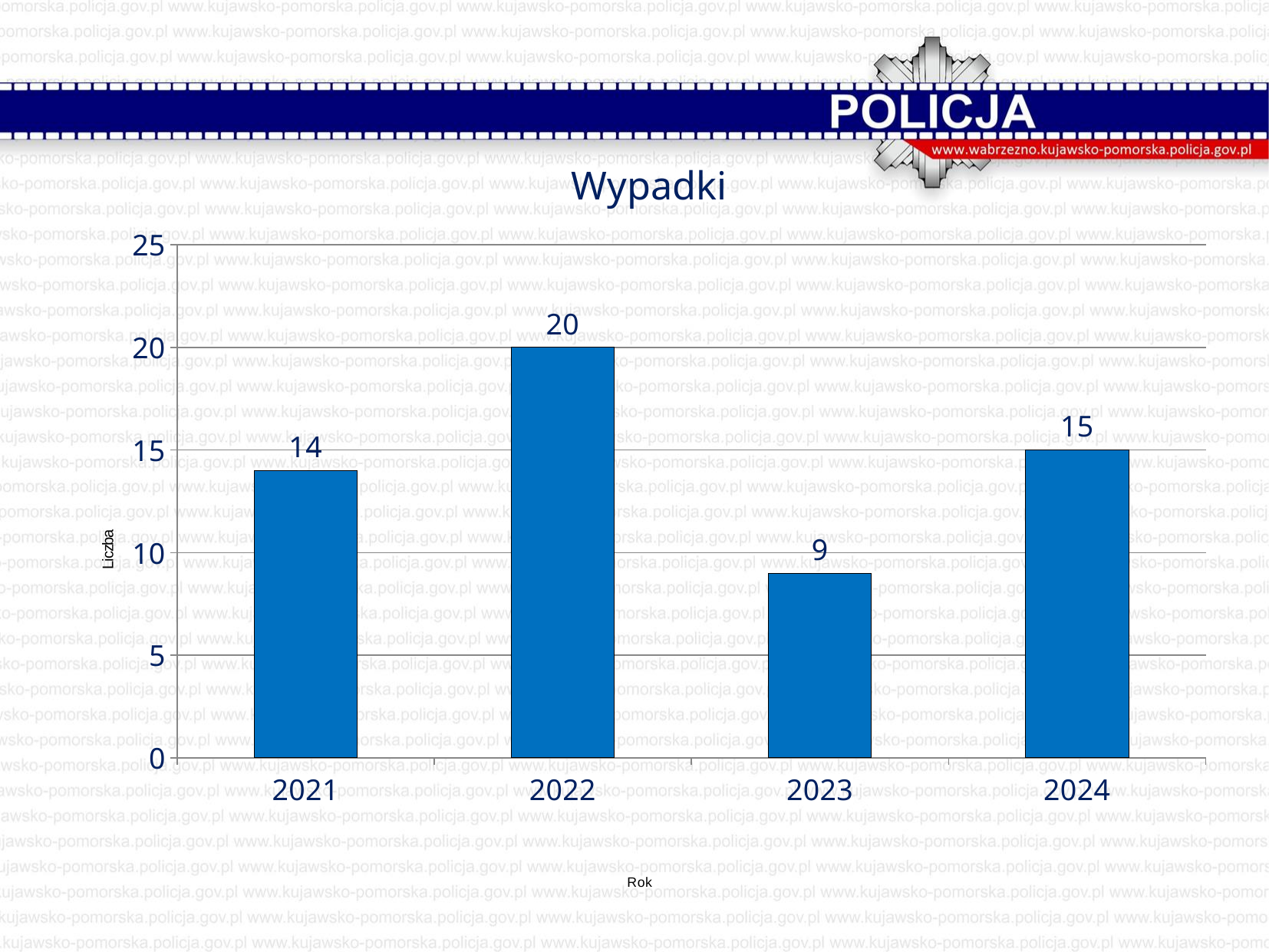
Does the value rise or fall from 2022 to 2023? fall What is the value for 2021? 14 What is the value for 2022? 20 What is the title of the chart? Wypadki What is the difference between the values for 2022 and 2023? 11 Which is larger, the value for 2021 or the value for 2024? 2024 What is the value for 2023? 9 Which year has the highest value? 2022 What is the value for 2024? 15 What kind of chart is this? bar chart Which year has the lowest value? 2023 How many years are shown on the x axis? 4